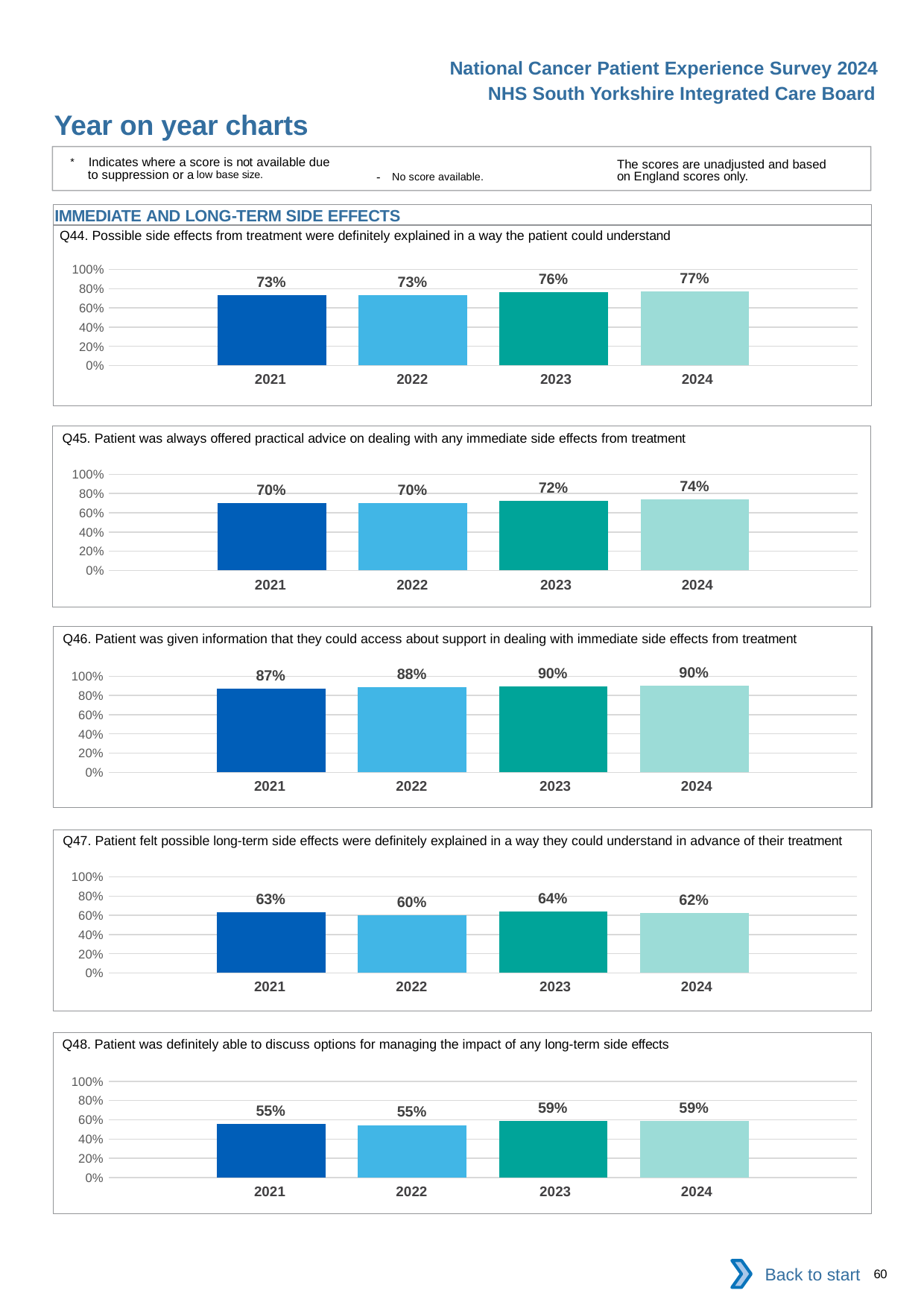
In the Q45 chart, do the values rise or fall from 2021 to 2024? Rise In the Q47 chart, which is larger, the value for 2023 or the value for 2024? 2023 In the Q46 chart, what is the value for 2021? 87% In the Q46 chart, which year has the highest value? 2023 and 2024 In the Q47 chart, which year has the lowest value? 2022 What kind of chart is the Q44 chart? Bar chart In the Q45 chart, what is the value for 2023? 72% In the Q48 chart, how many years are shown on the x axis? 4 In the Q48 chart, what is the difference between the 2023 and 2022 values? 4 percentage points In the Q44 chart, which year has the lowest value? 2021 and 2022 In the Q45 chart, what is the difference between the 2024 and 2021 values? 4 percentage points In the Q44 chart, what is the value for 2024? 77%